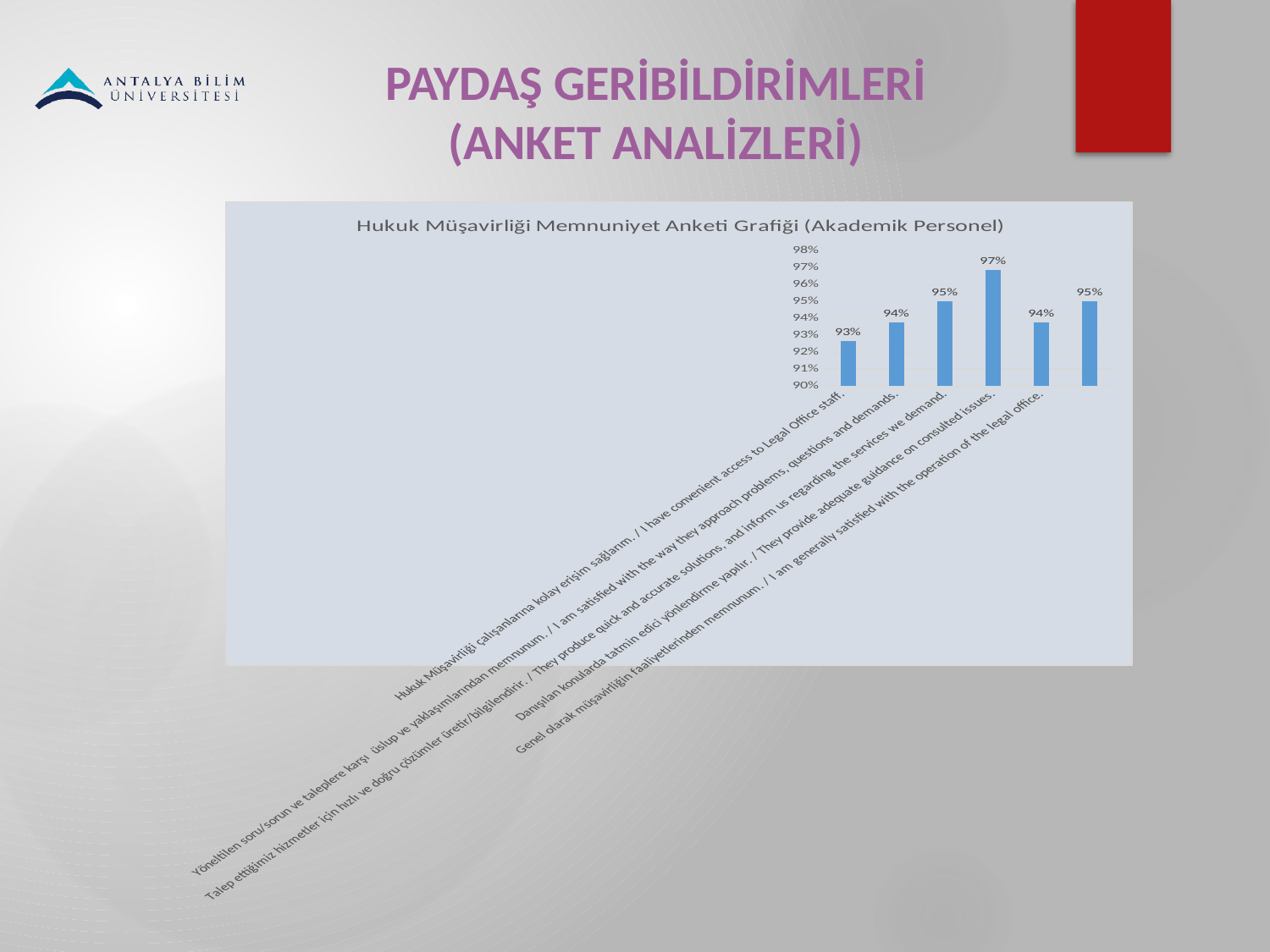
Is the value of the fourth bar greater or less than 96%? greater What is the value of the rightmost bar in the chart? 95% What is the title of the chart? Hukuk Müşavirliği Memnuniyet Anketi Grafiği (Akademik Personel) How many bars are plotted in the chart? 6 What is the value of the first (leftmost) bar, for 'I have convenient access to Legal Office staff'? 93% What is the lowest value shown in the chart? 93% What is the difference between the highest and lowest values in the chart? 4% What is the lowest value shown on the vertical axis? 90% What kind of chart is shown on the slide? bar chart Which is larger: the value of the first bar or the value of the fourth bar? the fourth bar What is the highest value shown in the chart? 97% What is the value for 'They provide adequate guidance on consulted issues'? 97%